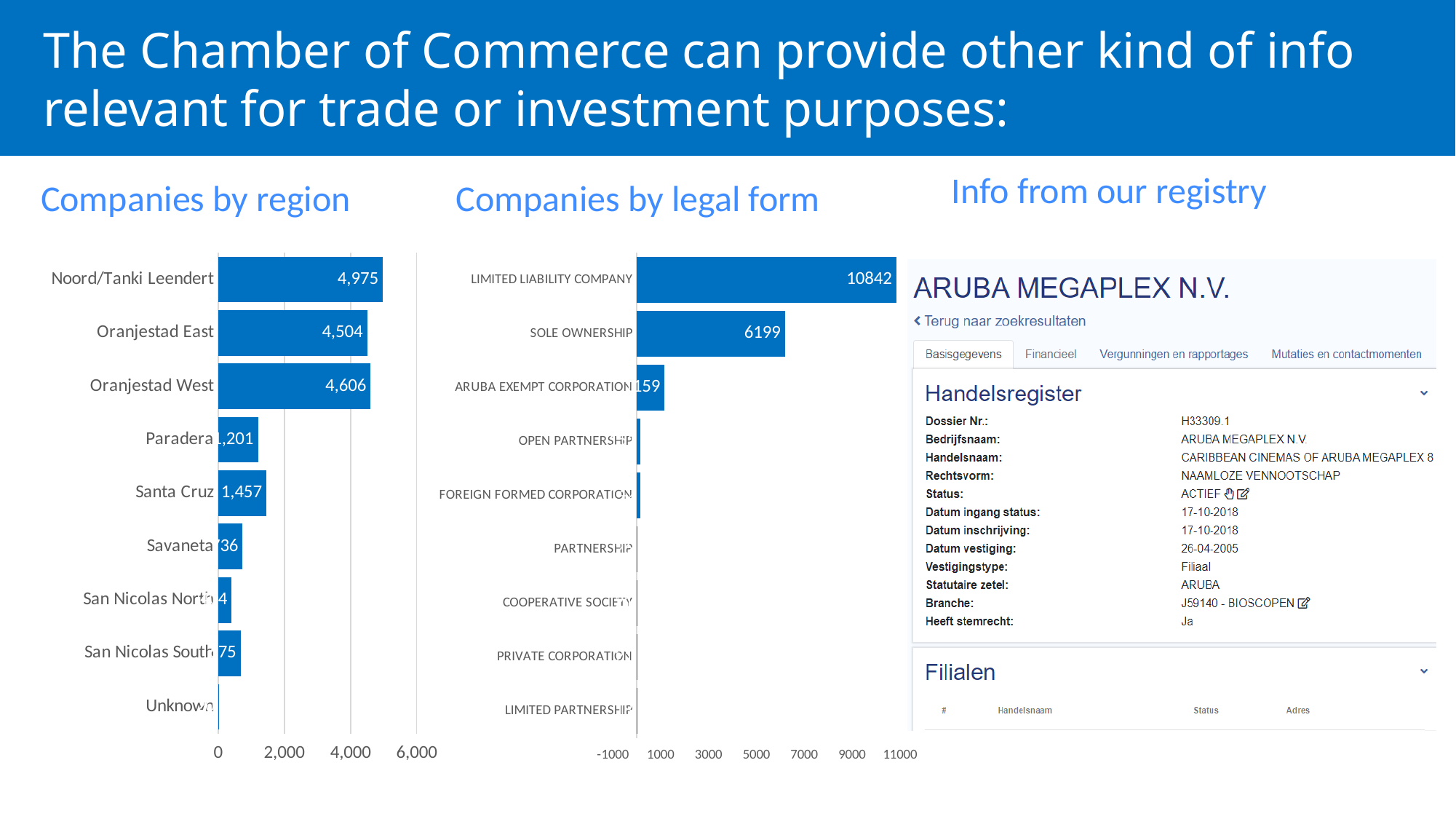
In the 'Companies by legal form' chart, what is the value for Limited Liability Company? 10842 In the 'Companies by legal form' chart, what is the difference between Limited Liability Company and Sole Ownership? 4643 In the 'Companies by region' chart, which region has the highest number of companies? Noord/Tanki Leendert In the 'Companies by region' chart, what is the value for Santa Cruz? 1,457 How many regions are shown in the 'Companies by region' chart? 9 What kind of chart is 'Companies by region'? Bar chart In the 'Companies by legal form' chart, what is the value for Sole Ownership? 6199 In the 'Companies by region' chart, what is the value for Oranjestad East? 4,504 In the 'Companies by region' chart, what is the difference between Noord/Tanki Leendert and Oranjestad West? 369 How many legal forms are listed in the 'Companies by legal form' chart? 9 In the 'Companies by region' chart, which has more companies, Oranjestad West or Oranjestad East? Oranjestad West In the 'Companies by region' chart, what is the value for Noord/Tanki Leendert? 4,975